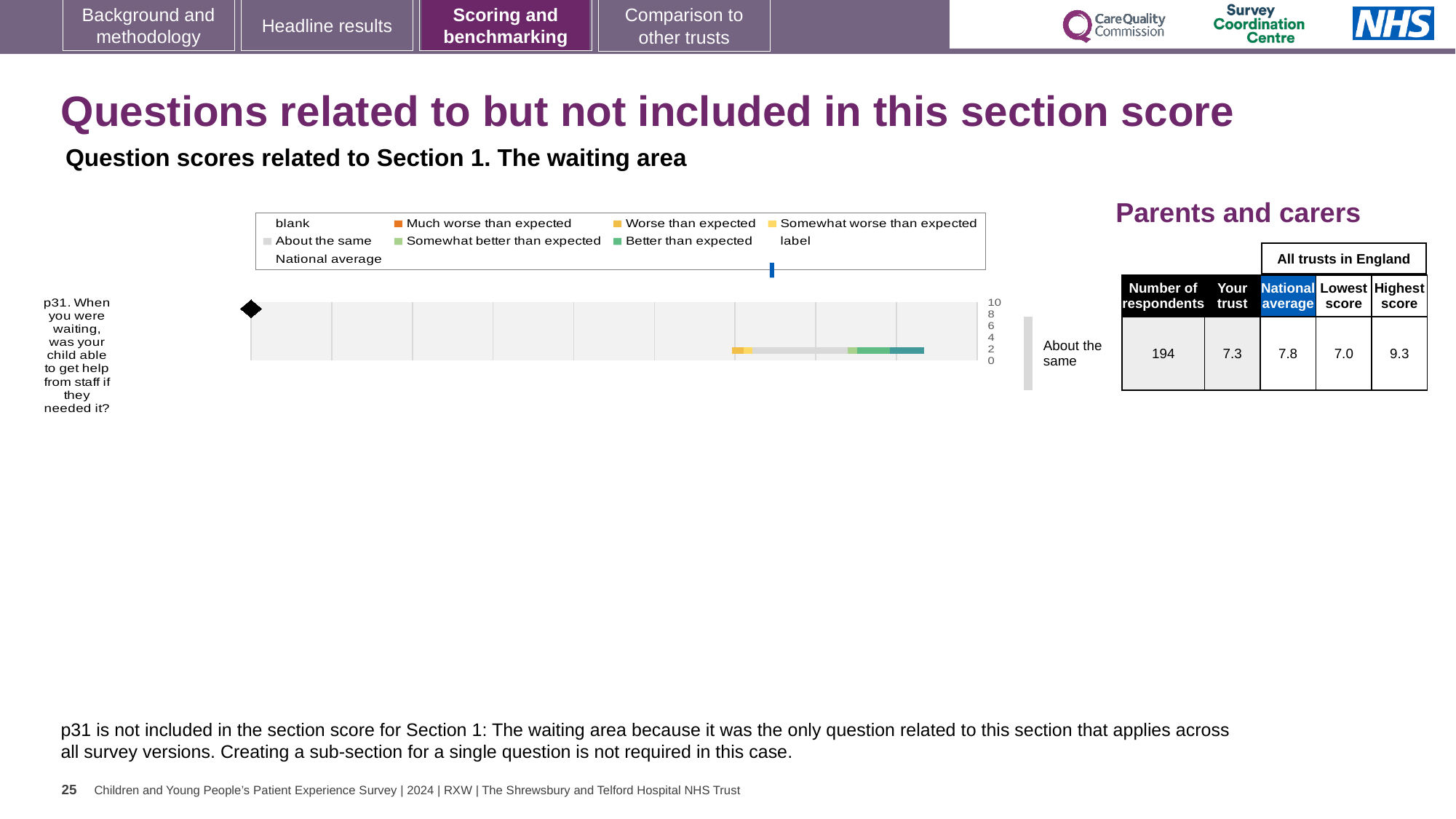
Which is larger for p31: the 'Your trust' score or the national average? National average What is the national average score for p31 in the Parents and carers table? 7.8 What is the difference between the highest and lowest scores across all trusts in England for p31? 2.3 What is the highest score across all trusts in England for p31? 9.3 What benchmark rating is shown next to the bar for p31? About the same How many questions (categories) are plotted in the chart? 1 Which question is plotted in the chart? p31. When you were waiting, was your child able to get help from staff if they needed it? What is the lowest score across all trusts in England for p31? 7.0 How many respondents answered p31? 194 What is the 'Your trust' score for p31 in the Parents and carers table? 7.3 What is the difference between the national average and the 'Your trust' score for p31? 0.5 What kind of chart is shown for question p31? Bar chart